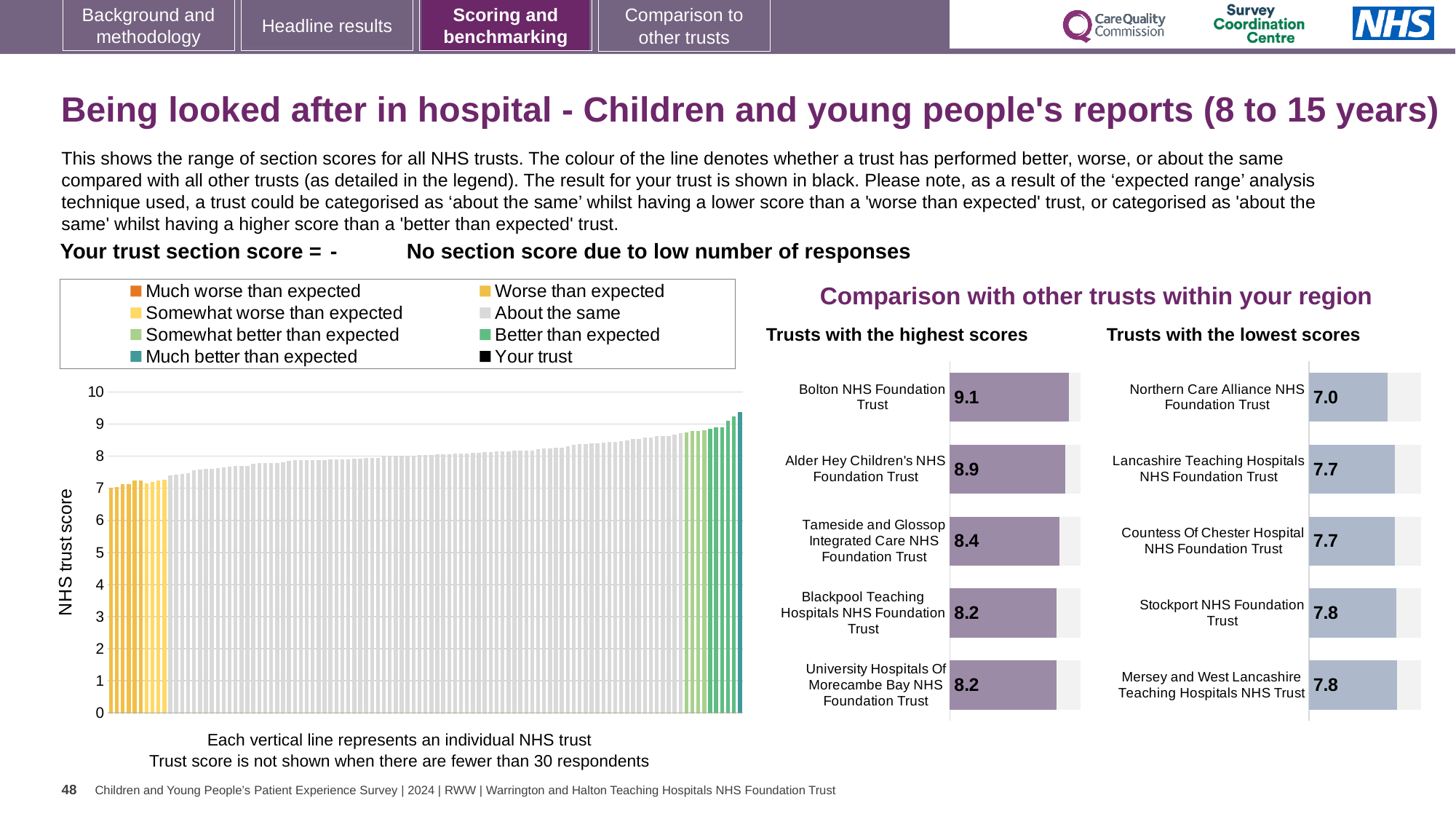
In the 'Trusts with the lowest scores' chart, which trust has the lowest score? Northern Care Alliance NHS Foundation Trust In the 'Trusts with the highest scores' chart, what is the score for Tameside and Glossop Integrated Care NHS Foundation Trust? 8.4 In the 'Trusts with the highest scores' chart, what is the difference between the scores of Bolton NHS Foundation Trust and Alder Hey Children's NHS Foundation Trust? 0.2 In the 'Trusts with the lowest scores' chart, what is the score for Stockport NHS Foundation Trust? 7.8 In the main chart on the left showing all NHS trusts, is the value of the tallest bar greater or less than 9? greater In the 'Trusts with the lowest scores' chart, what is the score for Northern Care Alliance NHS Foundation Trust? 7.0 In the 'Trusts with the highest scores' chart, what is the score for Bolton NHS Foundation Trust? 9.1 How many trusts are listed in the 'Trusts with the highest scores' chart? 5 In the 'Trusts with the lowest scores' chart, what is the difference between the scores of Mersey and West Lancashire Teaching Hospitals NHS Trust and Northern Care Alliance NHS Foundation Trust? 0.8 Which has a higher score: Alder Hey Children's NHS Foundation Trust in the highest scores chart or Lancashire Teaching Hospitals NHS Foundation Trust in the lowest scores chart? Alder Hey Children's NHS Foundation Trust In the main chart on the left showing all NHS trusts, do the scores rise or fall from left to right? rise In the 'Trusts with the highest scores' chart, which trust has the highest score? Bolton NHS Foundation Trust